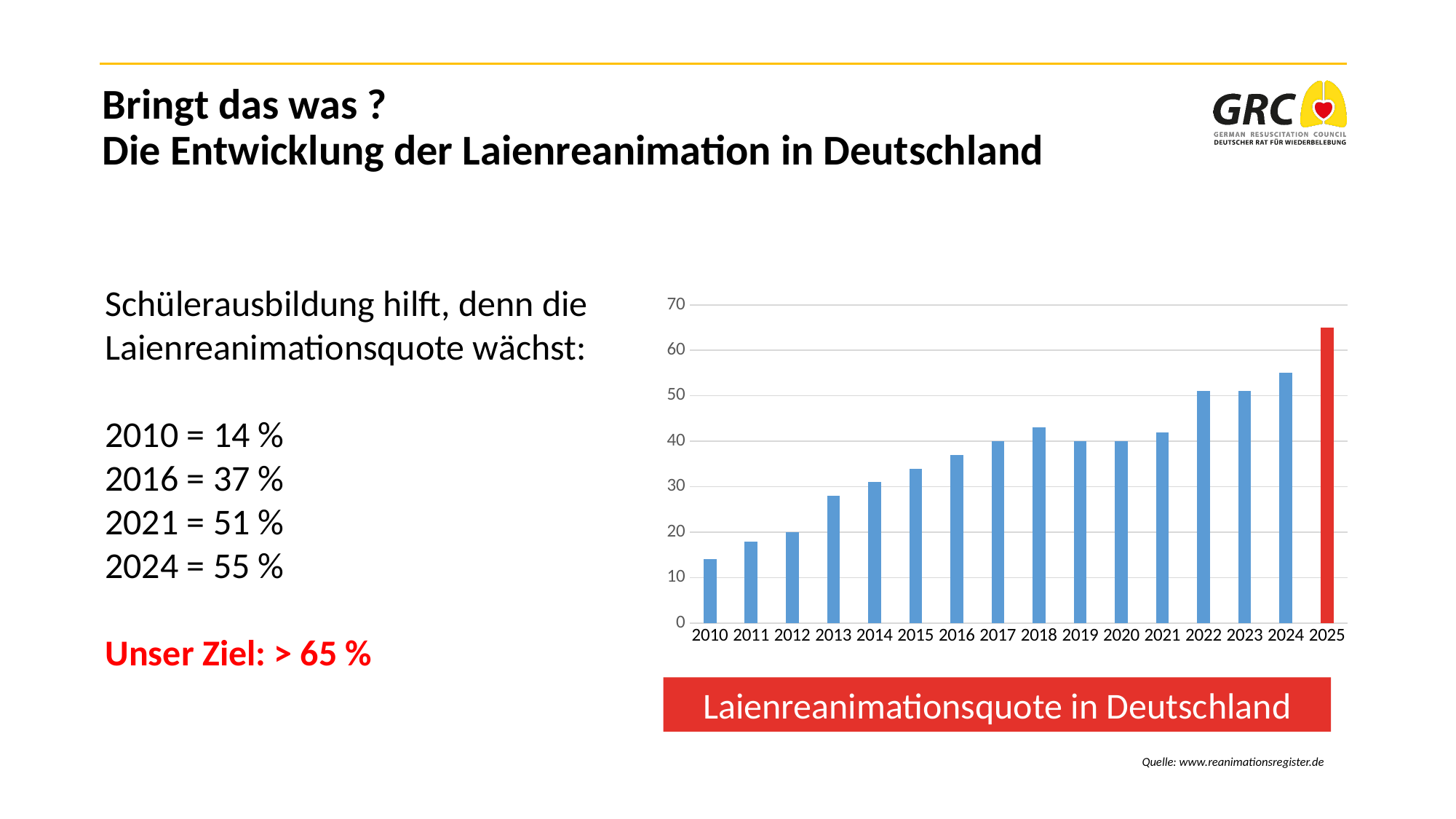
Do the values in the chart generally rise or fall from 2010 to 2025? rise Is the value for 2025 greater or less than 60? greater How many years are shown on the x axis of the chart? 16 Is the value for 2013 greater or less than 30? less What value does the bar for 2017 reach on the axis? 40 What kind of chart is shown on the slide? bar chart What value does the bar for 2012 reach on the axis? 20 What is the title shown in the red box below the chart? Laienreanimationsquote in Deutschland Which year has the highest bar in the chart? 2025 Which is larger, the value for 2018 or the value for 2019? 2018 Which year has the lowest bar in the chart? 2010